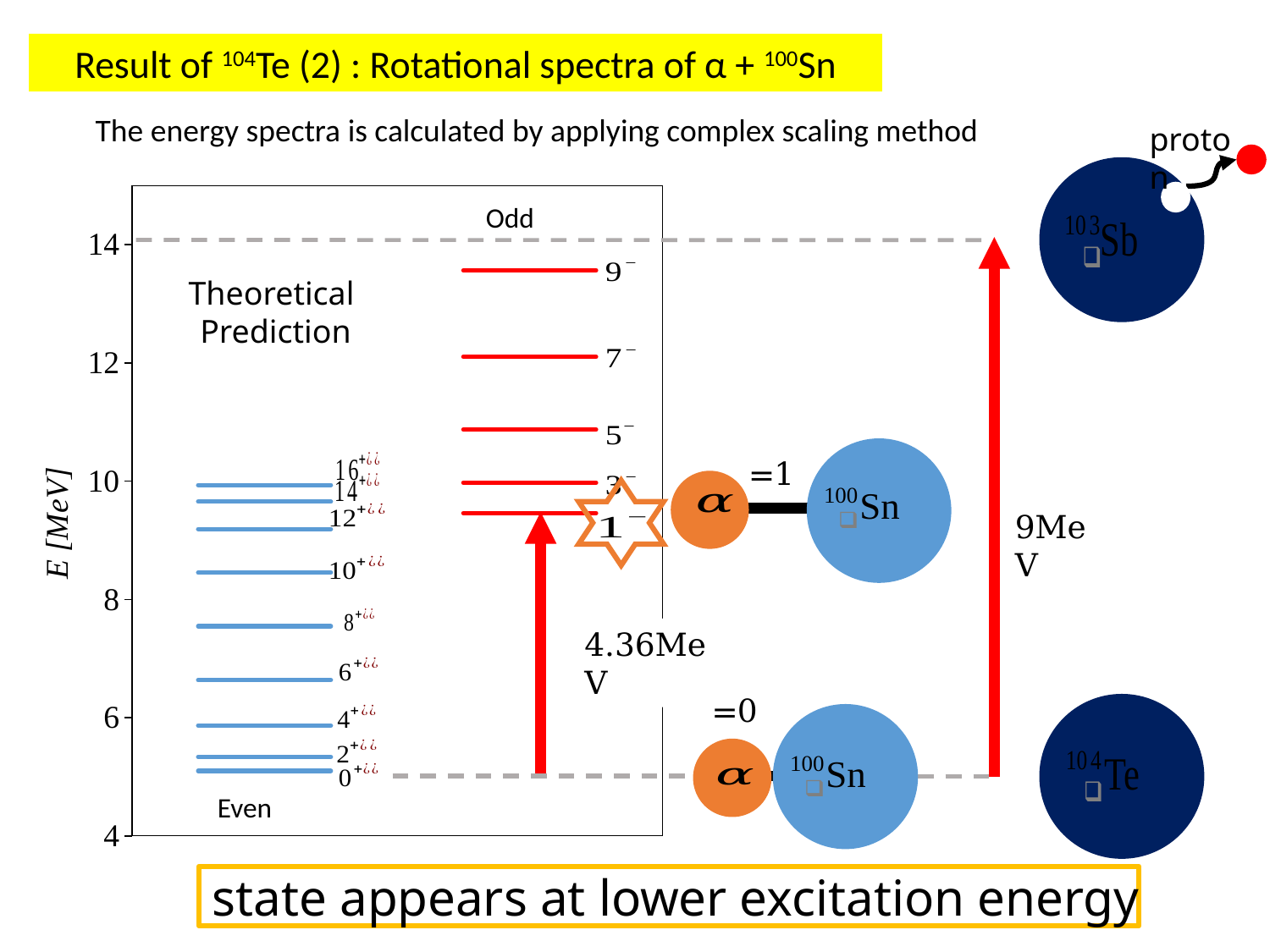
Is the energy of the 9⁻ level greater or less than 12 MeV? greater Is the energy of the 5⁻ level greater or less than 10 MeV? greater What is the label on the vertical axis of the energy level diagram? E [MeV] How many even-parity levels (blue lines) are drawn in the diagram? 9 What energy difference is labelled on the red arrow from the 0⁺ level up to the 1⁻ level? 4.36 MeV Is the energy of the 10⁺ level greater or less than 8 MeV? greater Which odd-parity level lies at the highest energy in the diagram? 9⁻ How many odd-parity levels (red lines) are drawn in the diagram? 5 Which level lies at a higher energy, 8⁺ or 5⁻? 5⁻ Which even-parity level lies at the lowest energy in the diagram? 0⁺ What energy difference is labelled on the tall red arrow on the right side of the diagram? 9 MeV